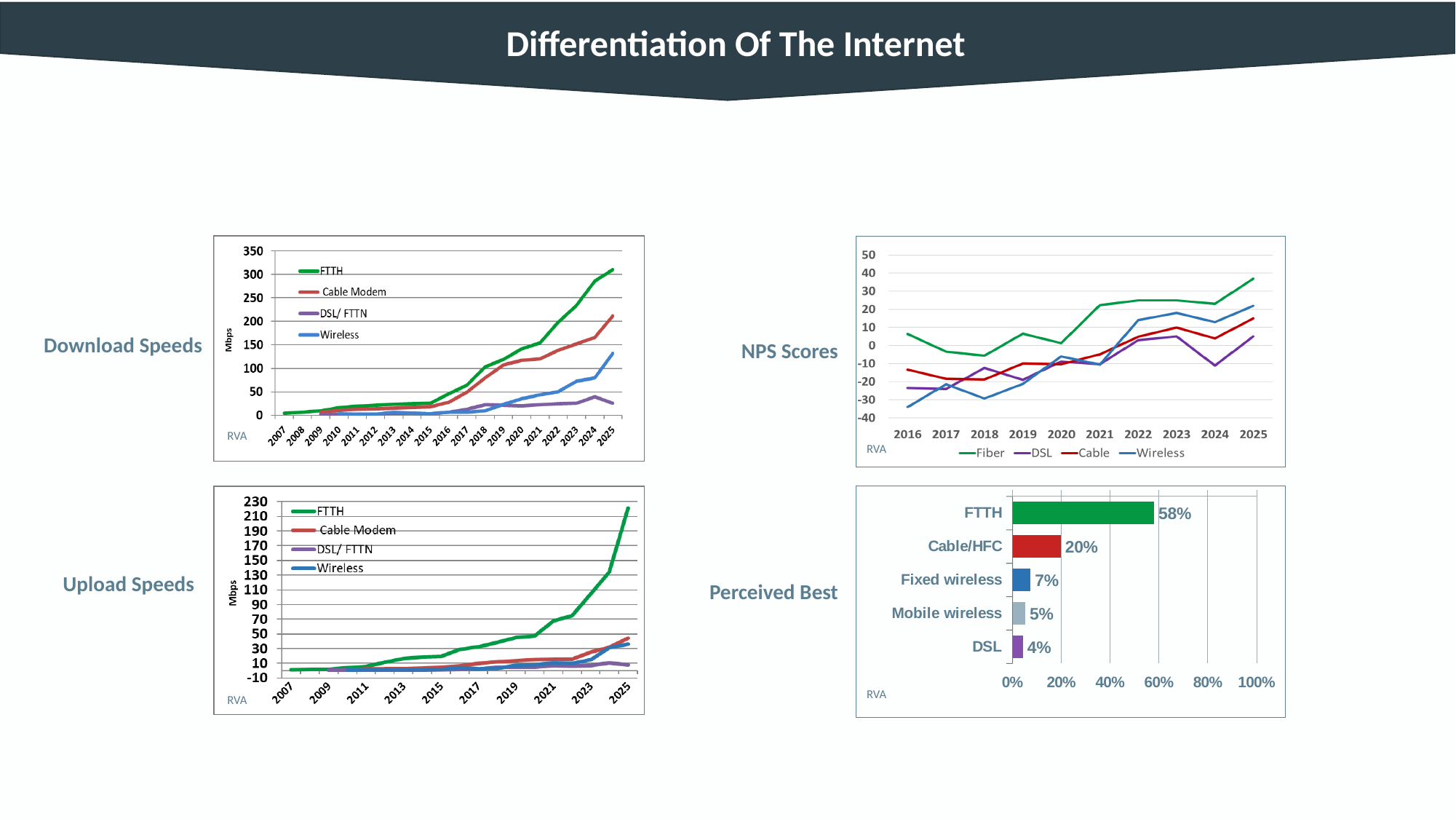
On the Perceived Best chart, what is the value for Cable/HFC? 20% On the Download Speeds chart, how many series does the legend list? 4 On the NPS Scores chart, how many years are shown on the x axis? 10 On the Perceived Best chart, which is larger, Fixed wireless or Mobile wireless? Fixed wireless On the Perceived Best chart, what is the value for FTTH? 58% On the Upload Speeds chart, is the FTTH value for 2025 greater or less than 200? greater On the Download Speeds chart, is the Cable Modem value for 2025 greater or less than 200? greater What kind of chart is the Perceived Best chart? bar chart On the Perceived Best chart, what is the difference between the FTTH and Cable/HFC values? 38% On the NPS Scores chart, which series has the highest value in 2025? Fiber On the Perceived Best chart, how many categories are shown? 5 On the Perceived Best chart, which category has the lowest value? DSL